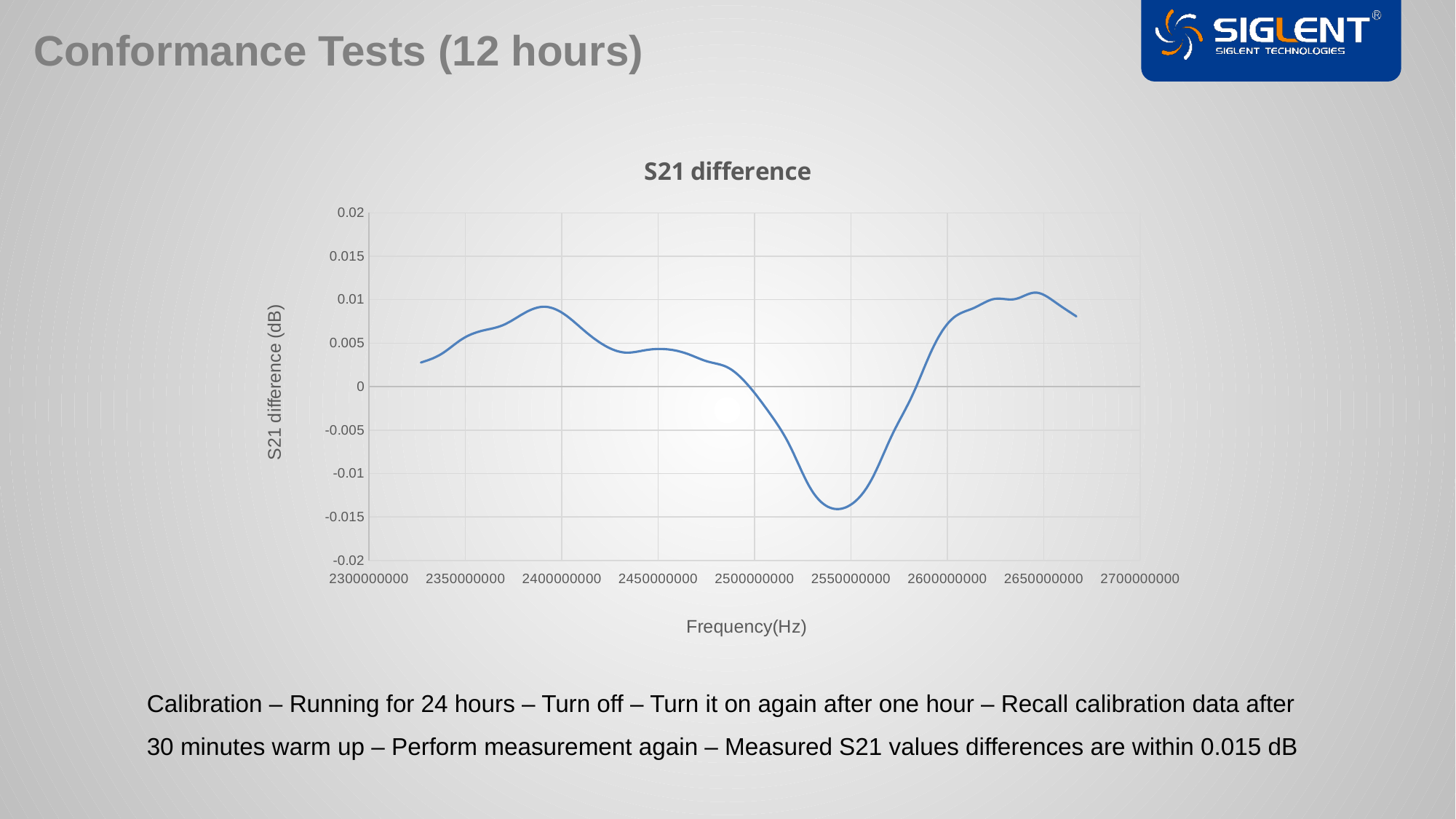
Is the S21 difference at 2550000000 Hz greater or less than -0.01? less What is the title of the chart? S21 difference What is the label of the vertical axis? S21 difference (dB) Which is larger, the S21 difference at 2400000000 Hz or at 2550000000 Hz? 2400000000 Hz What kind of chart is shown on the slide? line chart Is the S21 difference at 2400000000 Hz greater or less than 0.005? greater Does the line rise or fall between 2550000000 Hz and 2650000000 Hz? rise How many lines (series) are plotted on the chart? 1 Is the S21 difference at 2650000000 Hz greater or less than 0.005? greater Does the line rise or fall between 2500000000 Hz and 2550000000 Hz? fall Between which two x-axis ticks does the line reach its lowest value? between 2500000000 and 2550000000